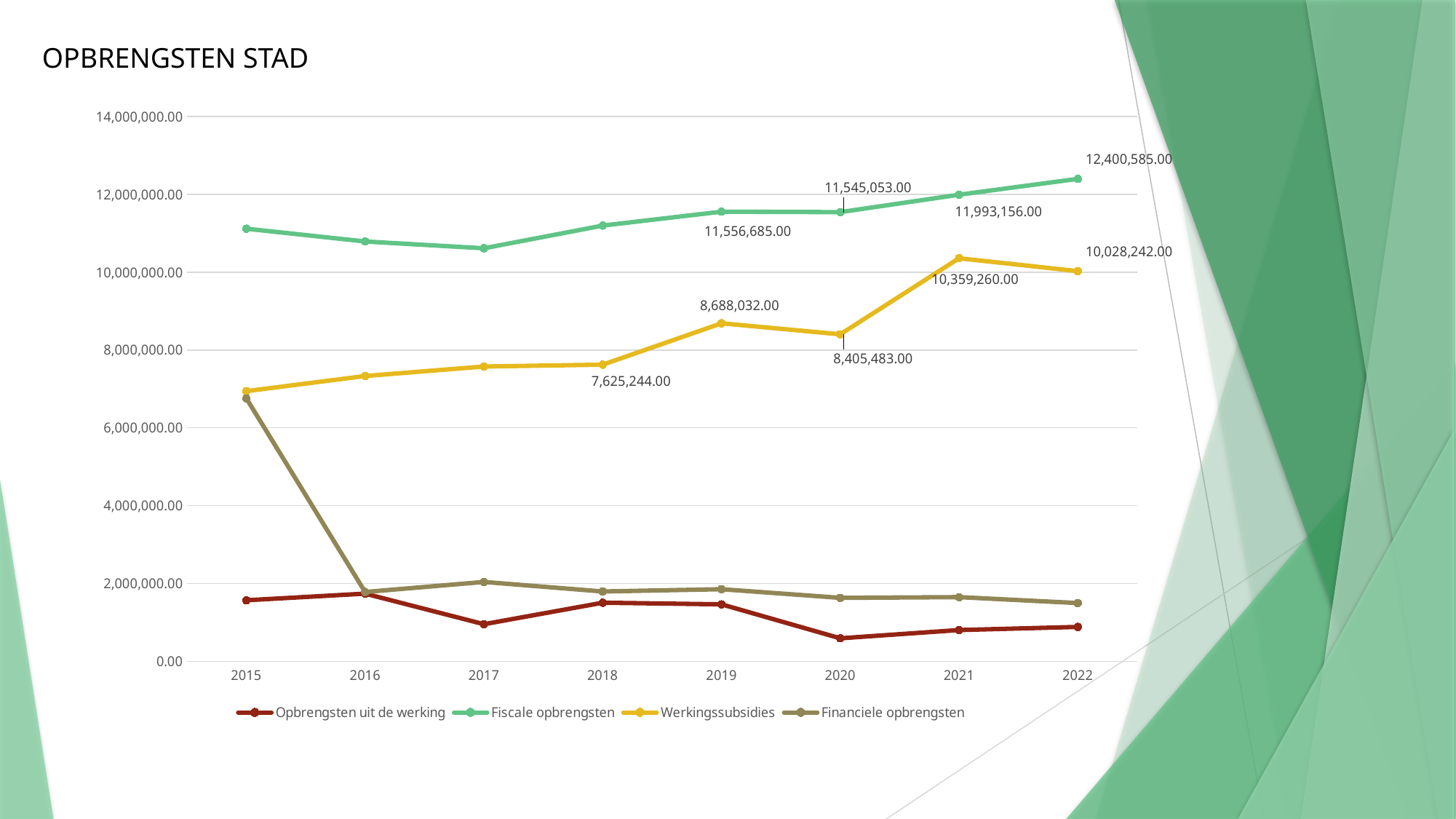
What is the value of Werkingssubsidies in 2021? 10,359,260.00 What kind of chart is shown on the slide? line chart How many series does the legend list? 4 What is the value of Werkingssubsidies in 2018? 7,625,244.00 Is the value for Opbrengsten uit de werking in 2020 greater or less than 2,000,000.00? less What is the value of Fiscale opbrengsten in 2020? 11,545,053.00 What is the value of Fiscale opbrengsten in 2022? 12,400,585.00 Is the value for Financiele opbrengsten in 2015 greater or less than 6,000,000.00? greater In which year are Werkingssubsidies highest? 2021 By how much did Fiscale opbrengsten increase from 2021 to 2022? 407,429.00 How many years are shown on the x axis? 8 What is the difference between Werkingssubsidies in 2019 and 2018? 1,062,788.00